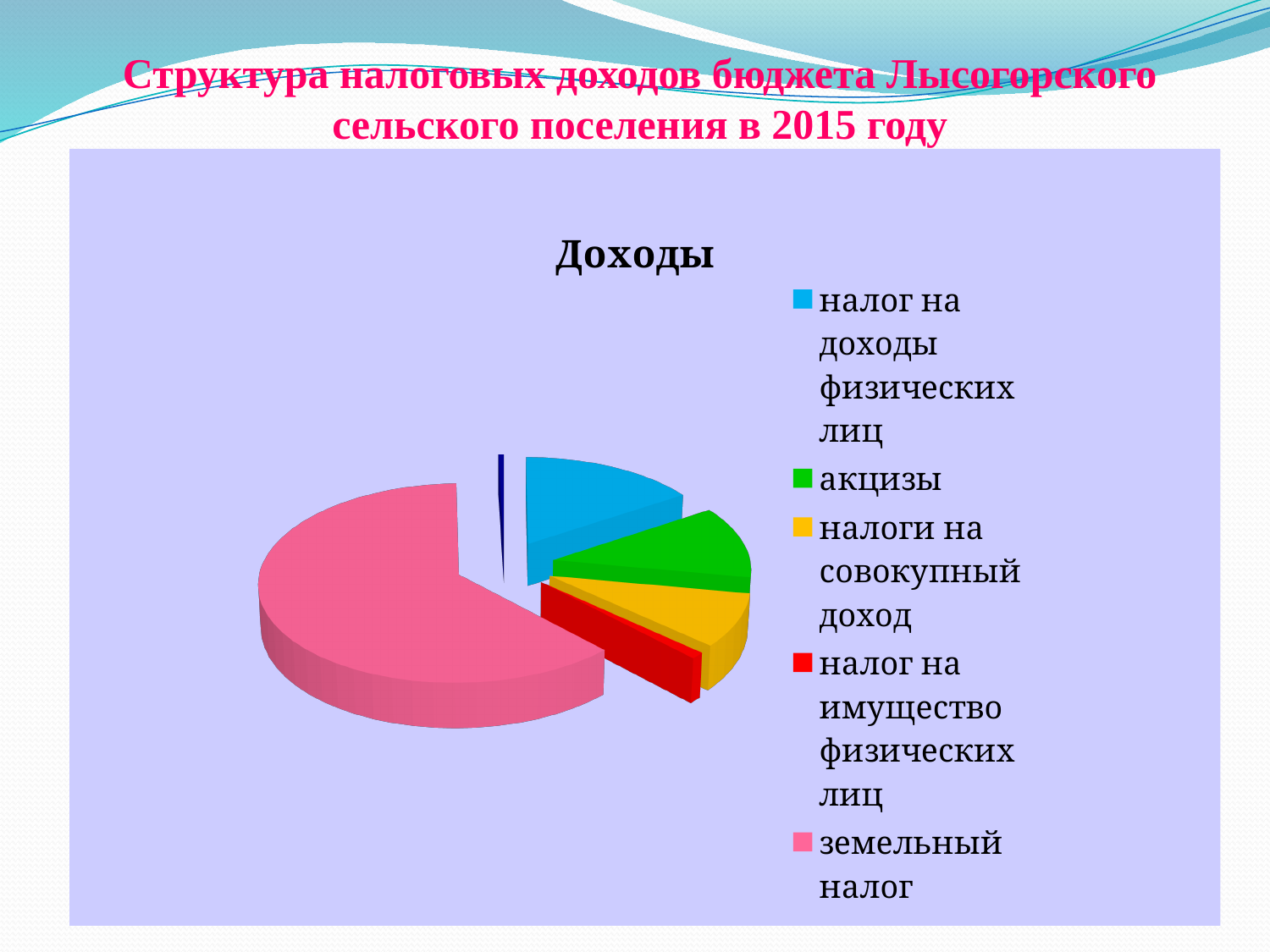
What colour is the slice for земельный налог? pink Is the земельный налог slice larger or smaller than half of the pie? larger What kind of chart is shown on the slide? pie chart Which category has the largest slice of the pie? земельный налог How many entries does the chart legend list? 5 Which slice is larger: налог на доходы физических лиц or налог на имущество физических лиц? налог на доходы физических лиц Which slice is larger: земельный налог or акцизы? земельный налог What is the title of the chart? Доходы